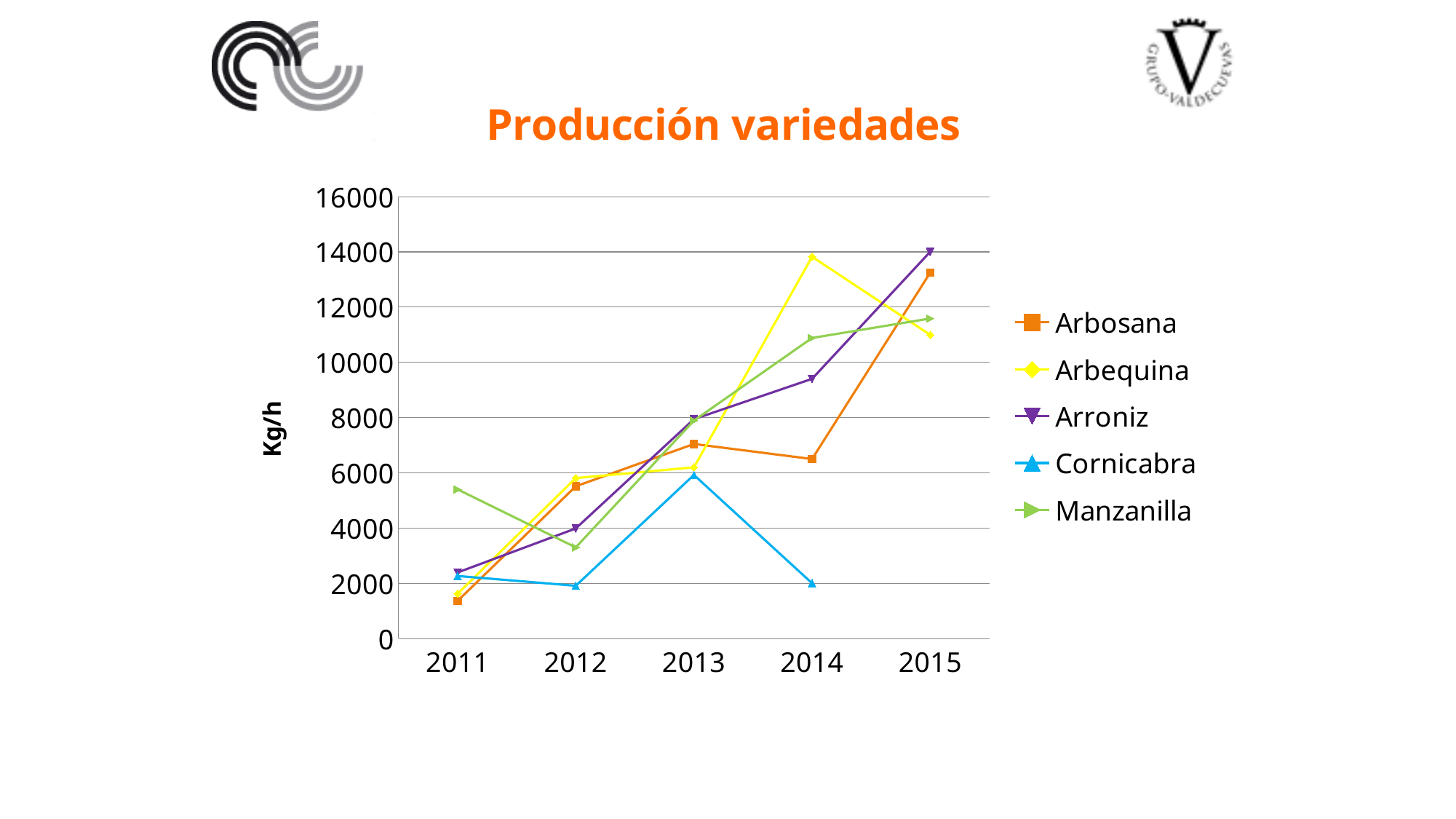
What is the title of the chart? Producción variedades Is the value for Cornicabra in 2014 greater or less than 4000? less How many years are shown on the x axis? 5 What kind of chart is shown on the slide? line chart Which variety has the highest value in 2014? Arbequina Which variety has the highest value in 2011? Manzanilla How many series does the legend list? 5 In 2015, which is larger: the value for Arroniz or the value for Arbosana? Arroniz Which variety has the lowest value in 2012? Cornicabra Is the value for Arbequina in 2014 greater or less than 12000? greater What is the label on the vertical axis? Kg/h Is the value for Manzanilla in 2011 greater or less than 4000? greater